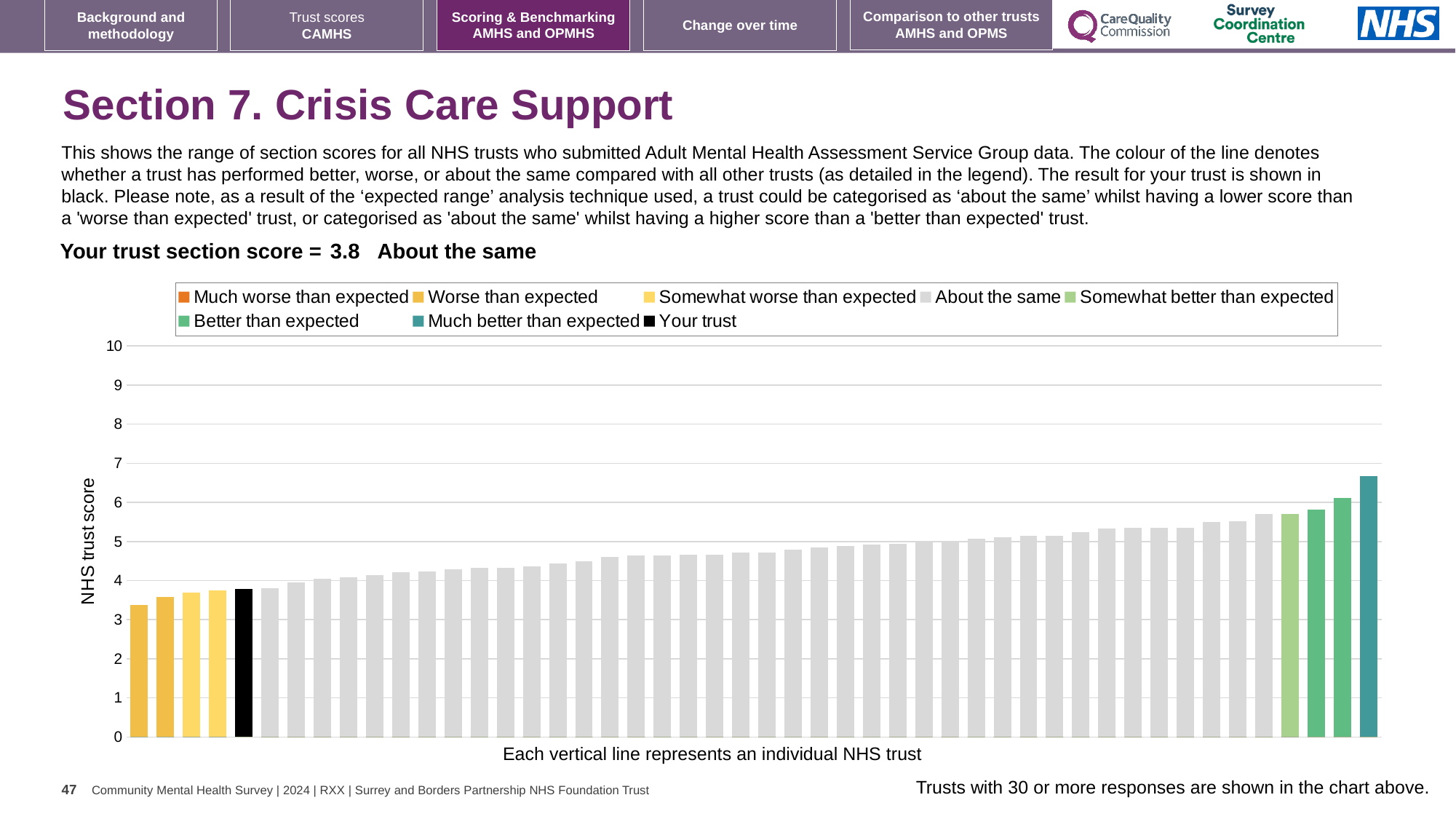
What kind of chart is shown on the slide? bar chart Is the value of the shortest bar in the chart greater or less than 4? less Do the bar values rise or fall from left to right across the chart? rise Which category does your trust's section score fall into, according to the slide? About the same What is the label on the vertical axis of the chart? NHS trust score Is the value of the tallest bar in the chart greater or less than 7? less Is the value of the tallest bar in the chart greater or less than 6? greater How many black bars representing 'Your trust' are in the chart? 1 How many entries does the chart legend list? 8 What is the section score for your trust shown on the slide? 3.8 What is the highest value shown on the vertical axis of the chart? 10